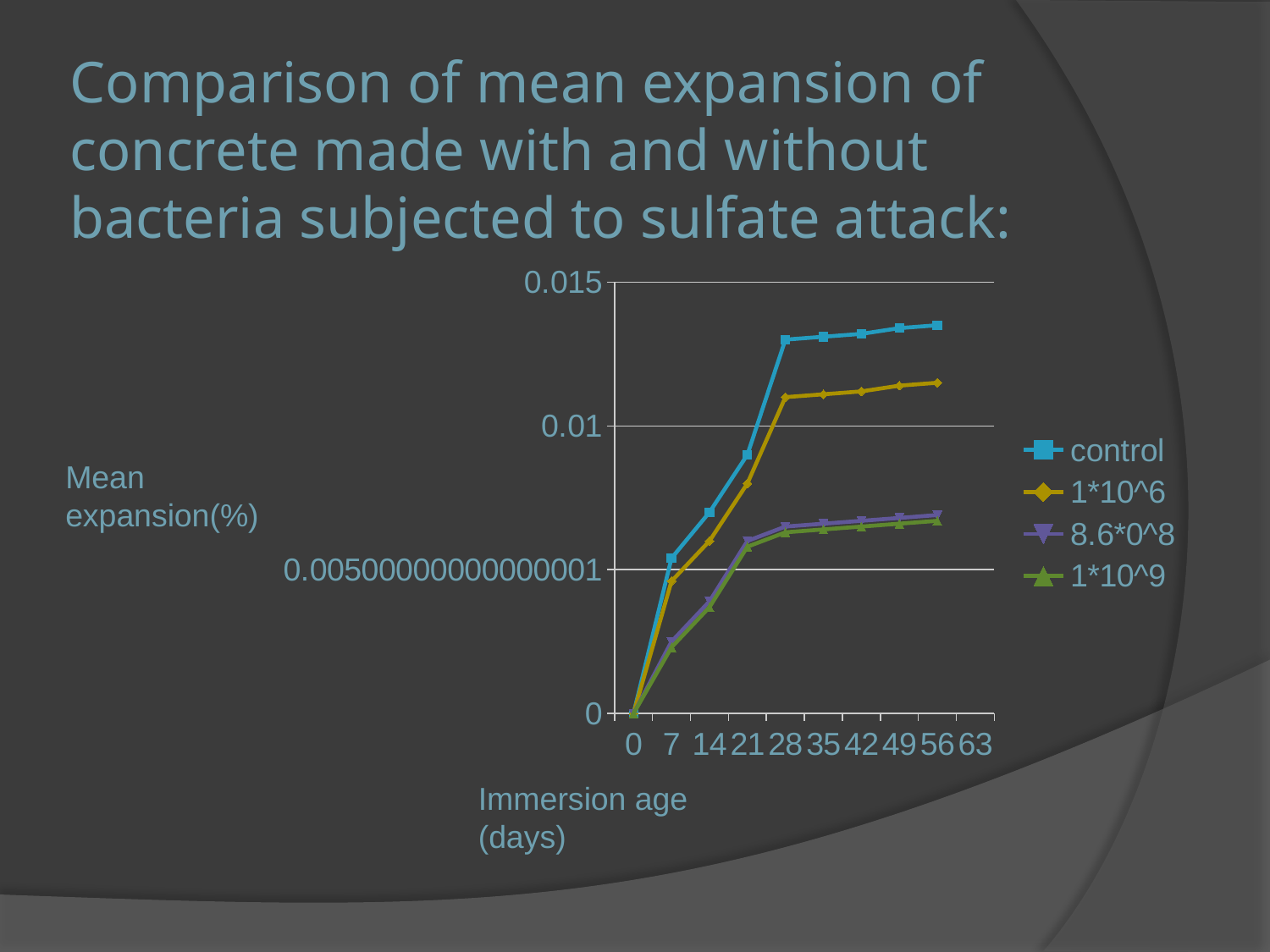
At 28 days, which is larger: the value for control or the value for 1*10^6? control Is the value for control at 56 days greater or less than 0.01? greater Which series has the highest mean expansion at 56 days? control Does the control series rise or fall as immersion age increases? rise What is the label of the x axis? Immersion age (days) Is the value for 1*10^9 at 56 days greater or less than 0.01? less What is the mean expansion for control at 0 days? 0 How many series does the legend list? 4 Is the value for 8.6*0^8 at 28 days greater or less than 0.01? less What kind of chart is shown on the slide? line chart How many tick labels are shown on the x axis? 10